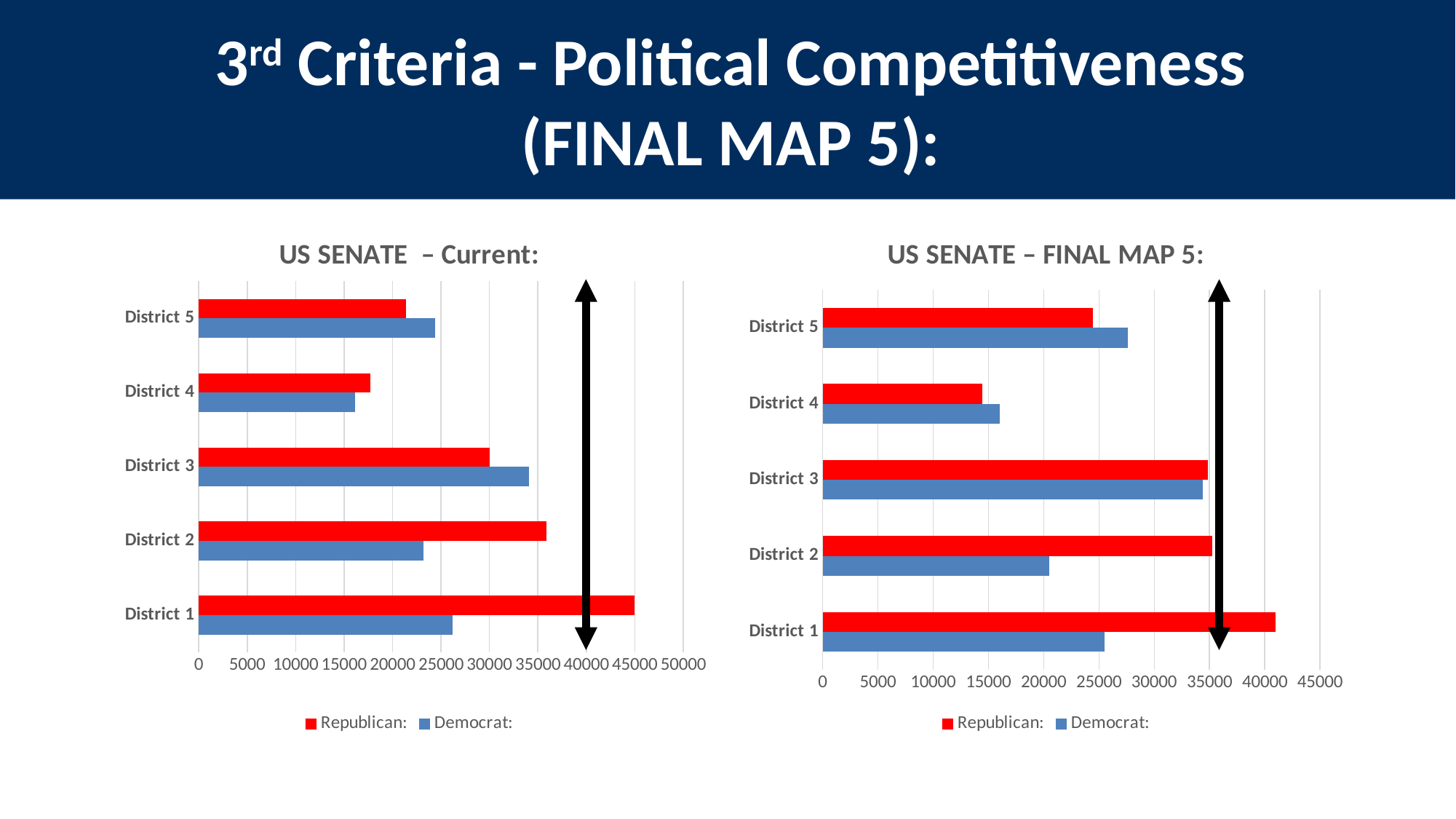
What kind of chart is the "US SENATE – Current:" chart? bar chart In the "US SENATE – FINAL MAP 5:" chart, which district has the lowest Republican value? District 4 In the "US SENATE – Current:" chart, which is larger for District 2, the Republican value or the Democrat value? Republican In the "US SENATE – Current:" chart, is the Democrat value for District 3 greater or less than 30000? greater In the "US SENATE – FINAL MAP 5:" chart, is the Republican value for District 1 greater or less than 40000? greater What are the two legend entries on the "US SENATE – Current:" chart? Republican and Democrat In the "US SENATE – FINAL MAP 5:" chart, is the Democrat value for District 2 greater or less than 25000? less In the "US SENATE – Current:" chart, which district has the highest Republican value? District 1 In the "US SENATE – Current:" chart, which district has the lowest Republican value? District 4 How many series does the legend of the "US SENATE – FINAL MAP 5:" chart list? 2 In the "US SENATE – FINAL MAP 5:" chart, which district has the highest Democrat value? District 3 How many districts are shown on the "US SENATE – Current:" chart? 5